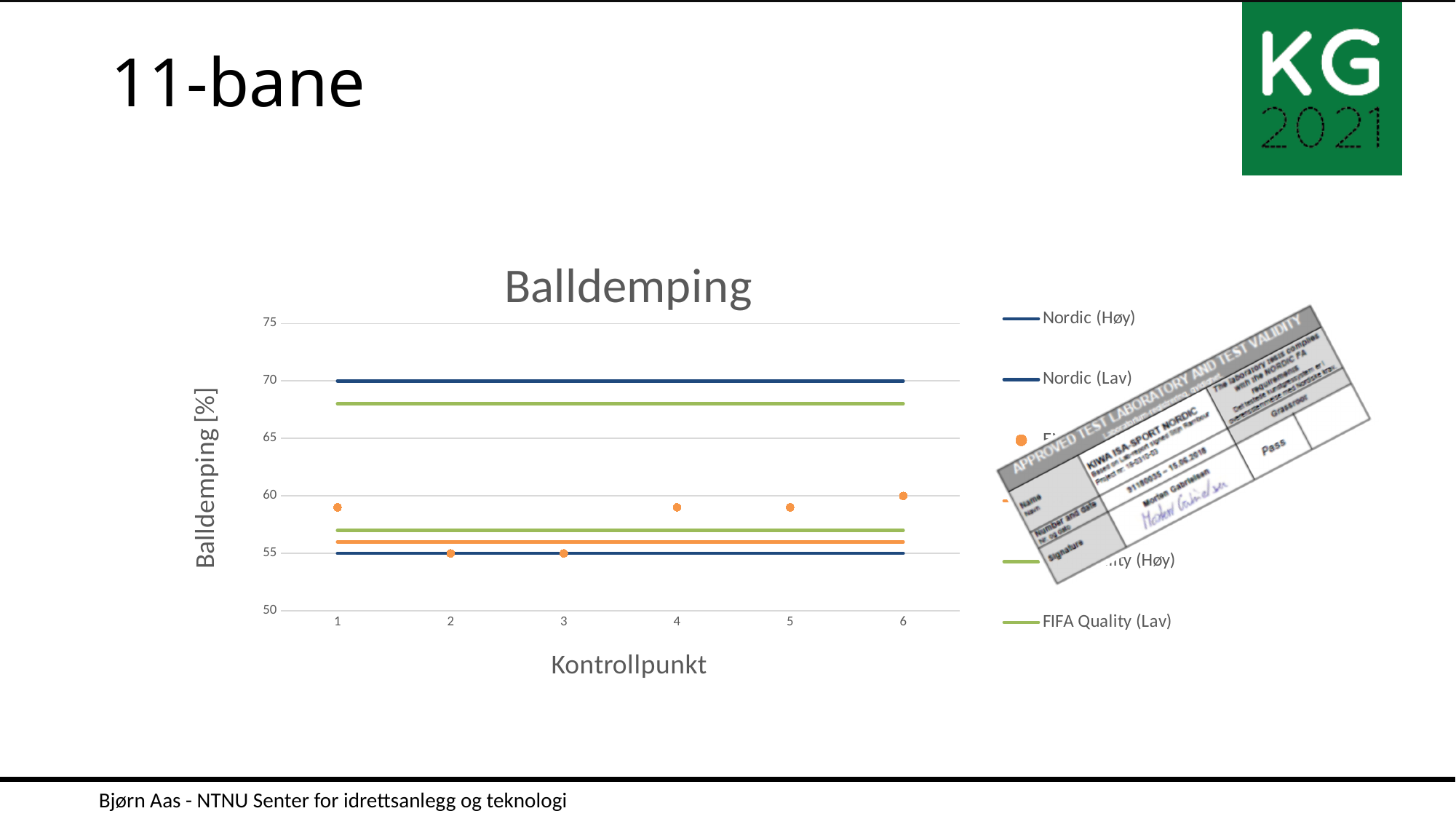
Is the value of the FIFA Quality (Høy) line greater or less than 65? greater What is the value of the orange data point at Kontrollpunkt 6? 60 What kind of chart is shown on the slide? line chart What is the value of the Nordic (Høy) line? 70 Is the value of the FIFA Quality (Lav) line greater or less than 60? less What is the difference between the Nordic (Høy) line and the Nordic (Lav) line? 15 What is the title of the chart? Balldemping Is the orange data point at Kontrollpunkt 1 greater or less than 60? less How many Kontrollpunkt values are shown on the x axis? 6 What is the value of the Nordic (Lav) line? 55 What is the label of the x axis? Kontrollpunkt Which is higher, the Nordic (Høy) line or the Nordic (Lav) line? Nordic (Høy)